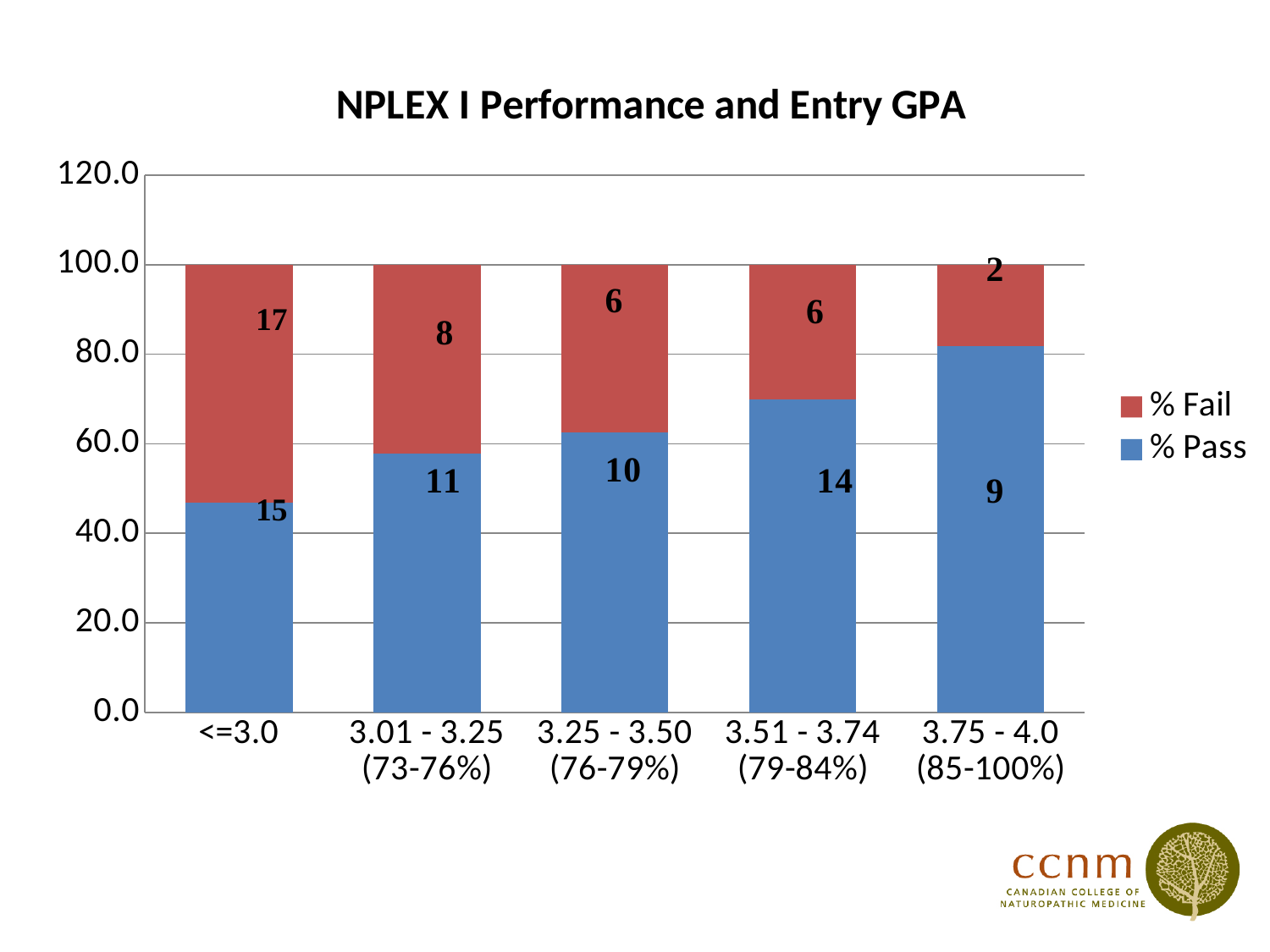
What is the title of the chart? NPLEX I Performance and Entry GPA Which GPA category has the highest % Pass? 3.75 - 4.0 (85-100%) Is the % Pass for the <=3.0 category greater or less than 60? less Is the % Pass for the 3.51 - 3.74 (79-84%) category greater or less than 60? greater What kind of chart is shown on the slide? bar chart How many GPA categories are shown on the x axis? 5 What number is printed on the % Fail segment of the <=3.0 bar? 17 What number is printed on the % Pass segment of the 3.51 - 3.74 (79-84%) bar? 14 Which GPA category has the lowest % Pass? <=3.0 Which has the larger % Pass: 3.25 - 3.50 (76-79%) or 3.51 - 3.74 (79-84%)? 3.51 - 3.74 (79-84%) Does the % Pass rise or fall as entry GPA increases along the x axis? rise How many series does the legend list? 2